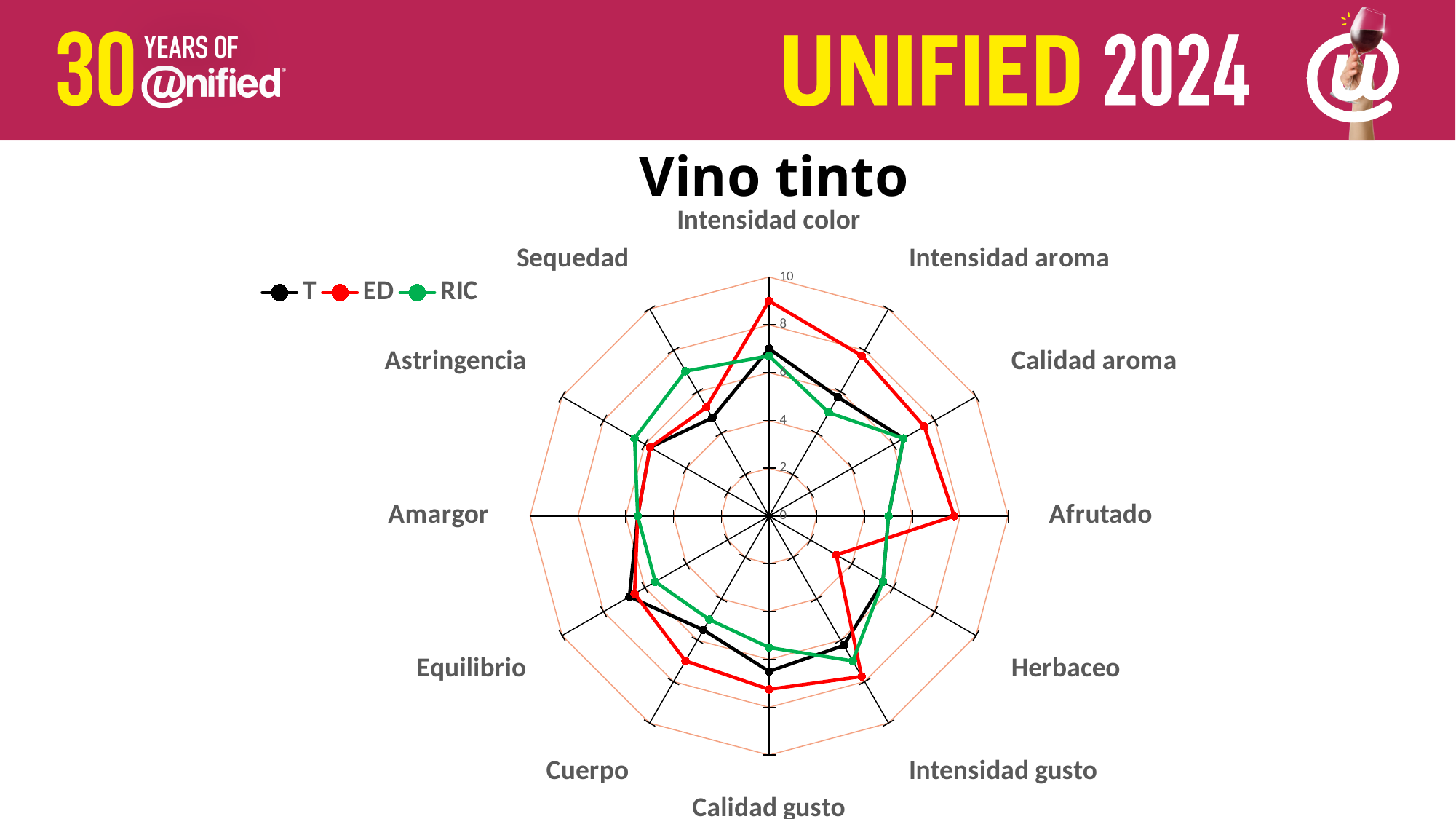
How many categories (axes) does the radar chart have? 12 What is the title of the chart? Vino tinto Is the ED value for Herbaceo greater or less than 4? less Is the T value for Intensidad color greater or less than 6? greater How many series does the legend list? 3 For Intensidad color, which series has the larger value, ED or T? ED Is the ED value for Cuerpo greater or less than 6? greater Which series has the highest value for Afrutado? ED Which series are listed in the legend? T, ED, RIC What kind of chart is shown on the slide? Radar chart